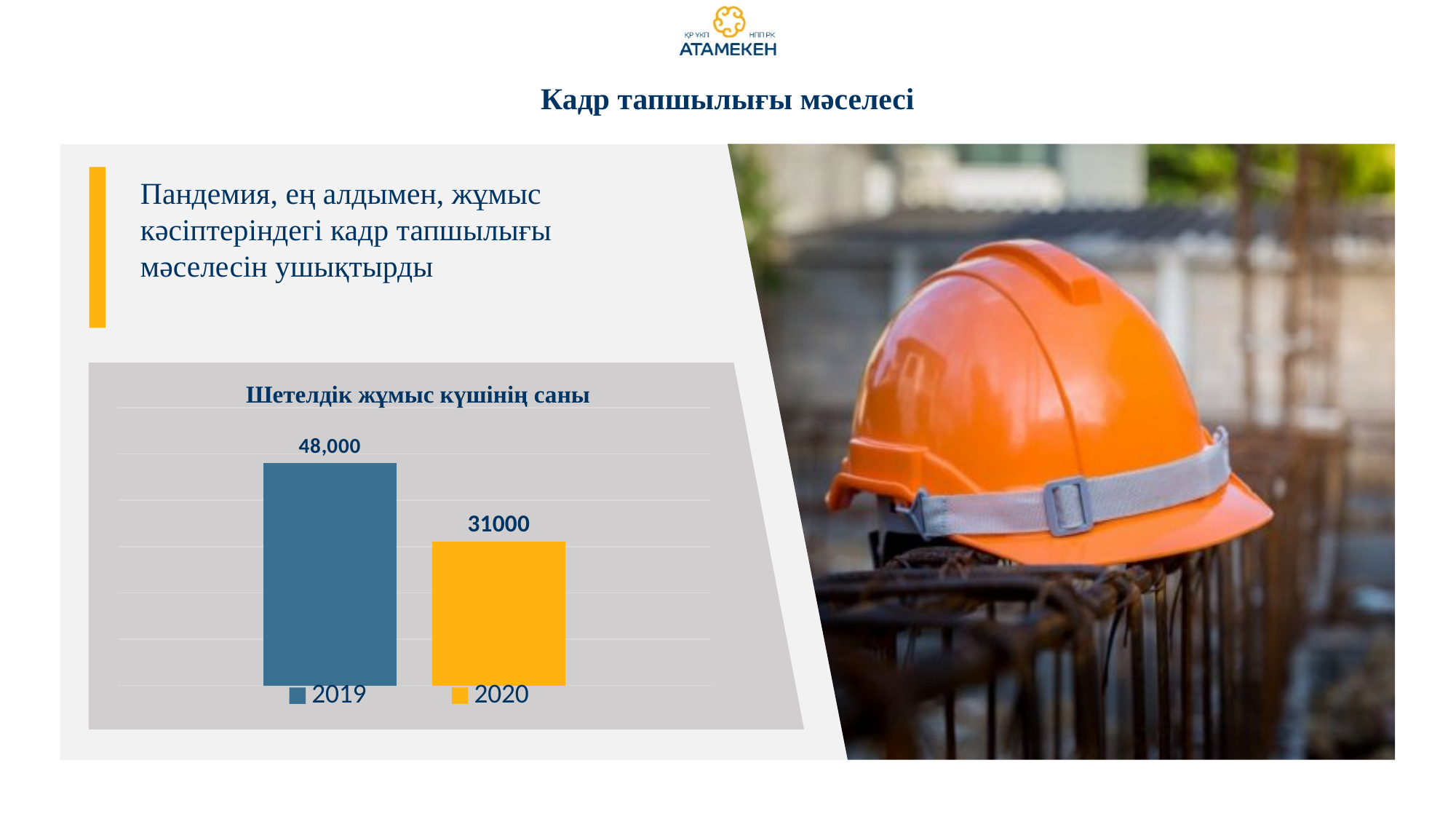
Is the value for 2020 larger or smaller than the value for 2019? smaller How many bars are shown in the chart? 2 What is the value for 2019 in the chart? 48,000 What kind of chart is shown on the slide? bar chart What colour is the bar for 2020? yellow What is the value for 2020 in the chart? 31000 How many entries does the chart legend list? 2 Which year has the higher value in the chart? 2019 What is the title of the chart? Шетелдік жұмыс күшінің саны Which year has the lower value in the chart? 2020 Do the values rise or fall from 2019 to 2020? fall What is the difference between the 2019 and 2020 values? 17,000